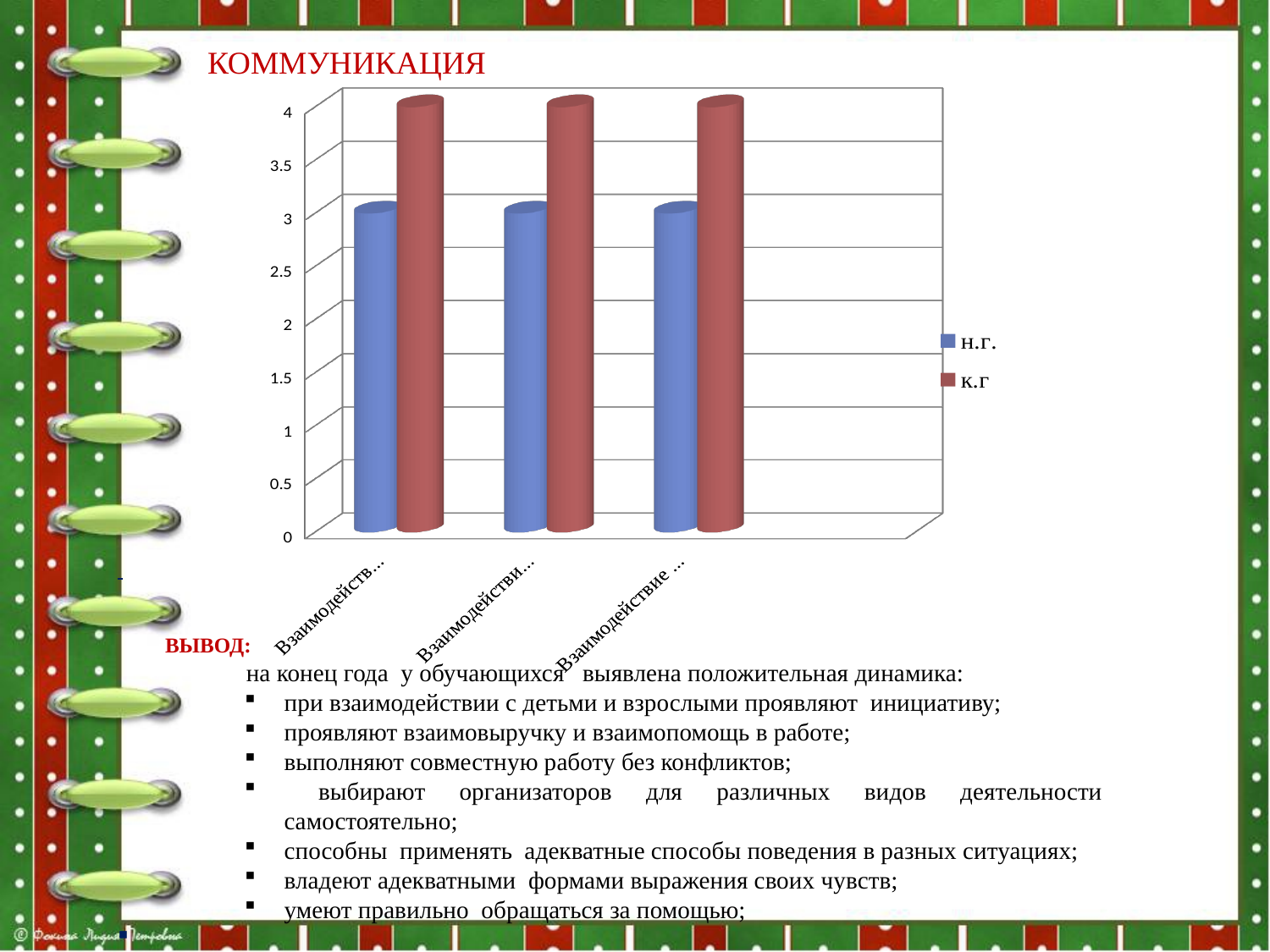
How many series does the chart legend list? 2 Is the value of the н.г. series in the first category greater or less than 3.5? less Which series has the higher value in the first category, н.г. or к.г? к.г How many categories are plotted on the x axis of the chart? 3 Is the value of the н.г. series in the third category greater or less than 2? greater What kind of chart is shown on the slide? bar chart What is the value of the к.г series in the first category? 4 What is the value of the н.г. series in the second category? 3 What are the two series named in the chart legend? н.г. and к.г Which series has the higher value in the third category, н.г. or к.г? к.г What is the title of the slide above the chart? КОММУНИКАЦИЯ Is the value of the к.г series in the second category greater or less than 3.5? greater